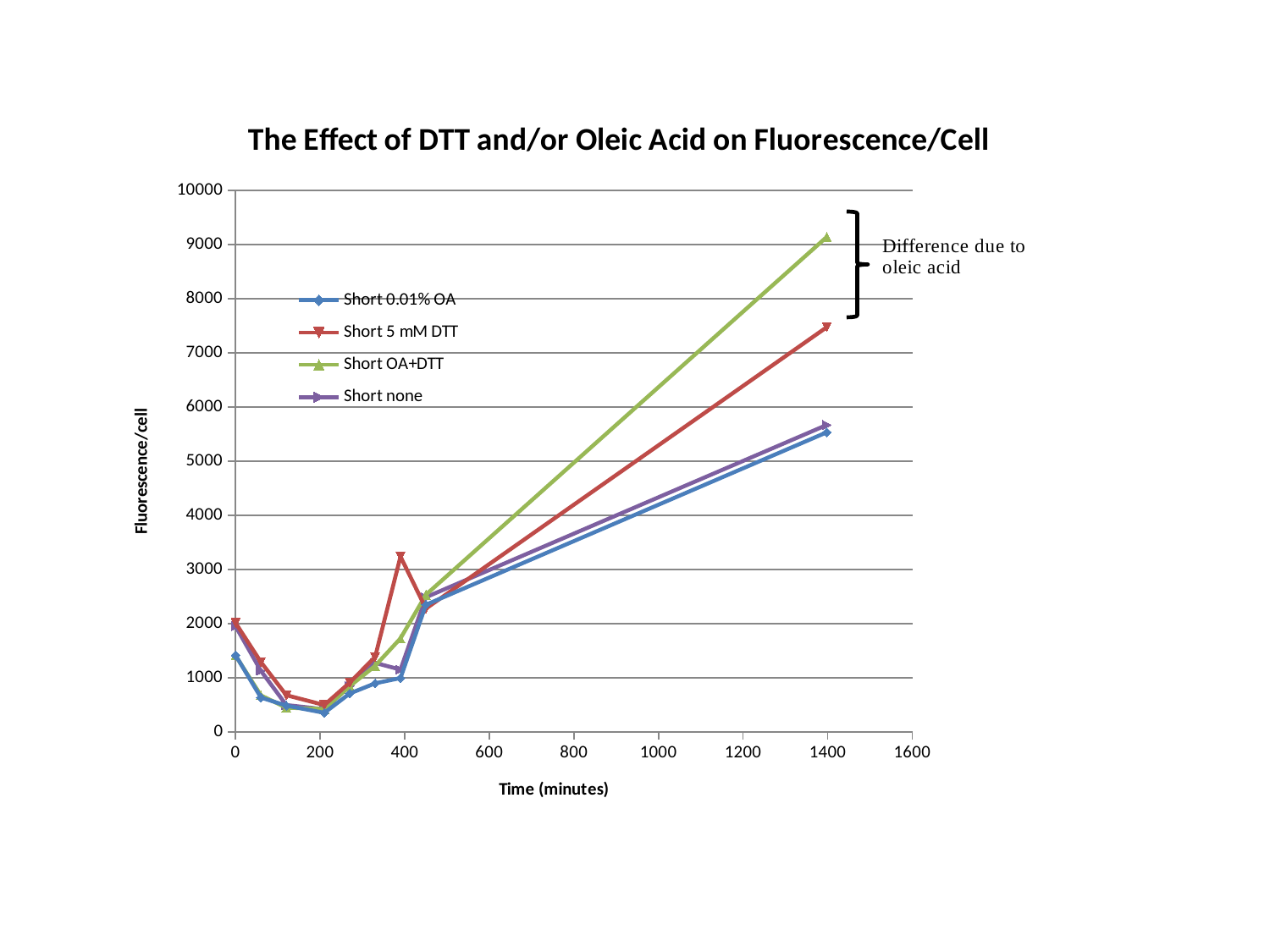
What kind of chart is shown on the slide? line chart Is the value for Short OA+DTT at 1400 minutes greater or less than 8000? greater Is the value for Short 0.01% OA at 0 minutes greater or less than 1000? greater What does the annotation next to the bracket on the right of the chart say? Difference due to oleic acid At 1400 minutes, which is larger: Short 5 mM DTT or Short none? Short 5 mM DTT What is the title of the chart? The Effect of DTT and/or Oleic Acid on Fluorescence/Cell Which series has the highest fluorescence/cell at 1400 minutes? Short OA+DTT Which series shows the sharp spike to the highest value at around 400 minutes? Short 5 mM DTT Is the value for Short none at 1400 minutes greater or less than 6000? less How many series does the legend list? 4 Between about 450 and 1400 minutes, do the values for Short OA+DTT rise or fall? rise